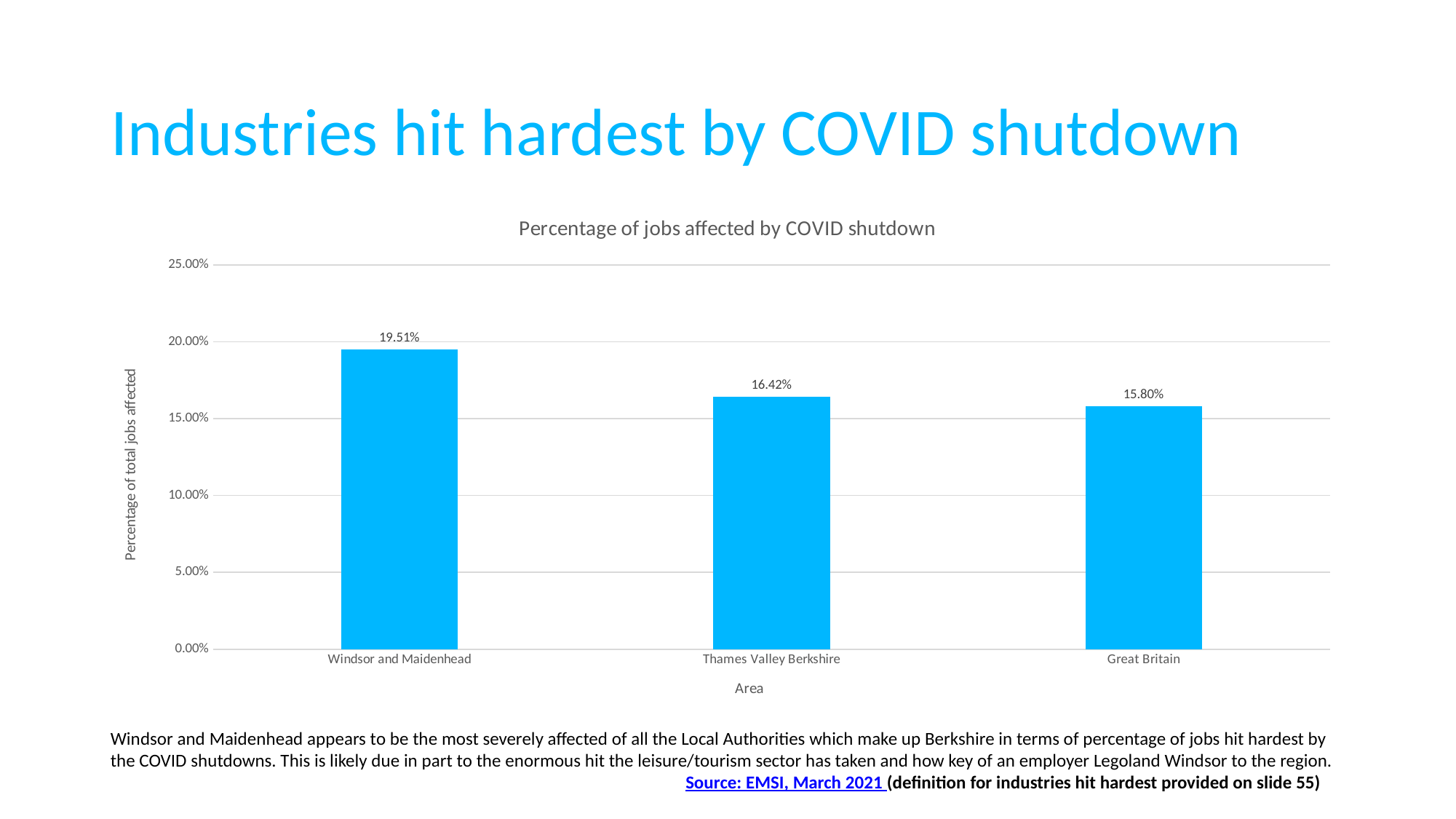
What is the difference in percentage points between Windsor and Maidenhead and Great Britain? 3.71 Is the value for Windsor and Maidenhead greater or less than 20.00%? less How many areas are shown on the chart? 3 What percentage of total jobs were affected in Great Britain? 15.80% Which has a higher percentage of jobs affected, Thames Valley Berkshire or Great Britain? Thames Valley Berkshire What is the value shown for Thames Valley Berkshire? 16.42% Which area has the highest percentage of jobs affected by the COVID shutdown? Windsor and Maidenhead What type of chart is shown on the slide? Bar chart What is the difference in percentage points between Windsor and Maidenhead and Thames Valley Berkshire? 3.09 What is the title of the chart? Percentage of jobs affected by COVID shutdown Which area has the lowest percentage of jobs affected? Great Britain What percentage of jobs were affected by the COVID shutdown in Windsor and Maidenhead? 19.51%